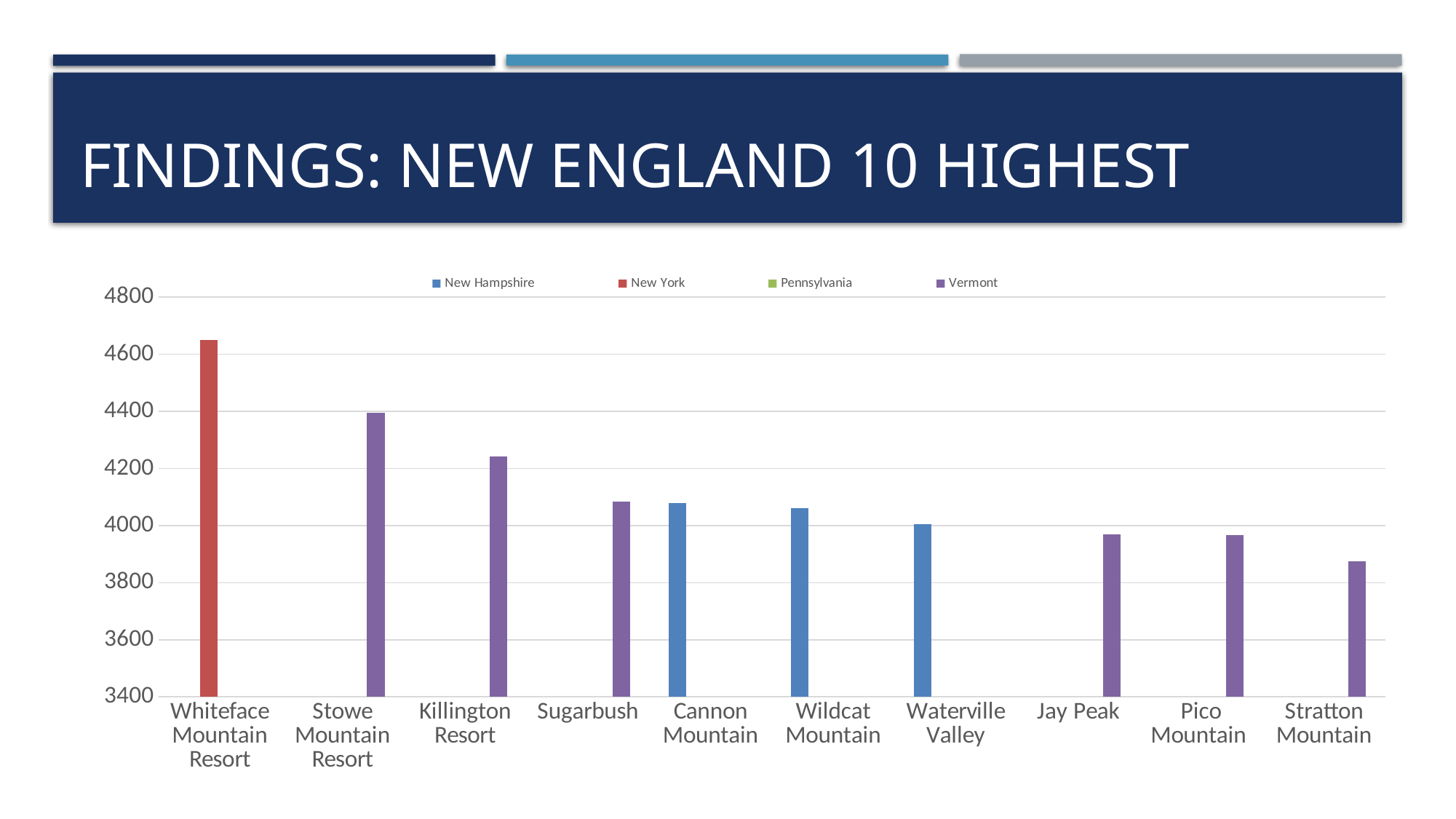
Is the value for Stratton Mountain greater or less than 4000? less Which resort has the highest bar? Whiteface Mountain Resort Do the bar values rise or fall from left to right across the chart? fall What kind of chart is shown on the slide? bar chart Is the value for Wildcat Mountain greater or less than 4000? greater Is the value for Killington Resort greater or less than 4200? greater How many series does the legend list? 4 How many resorts are plotted on the chart? 10 Which is larger, the value for Stowe Mountain Resort or Killington Resort? Stowe Mountain Resort Which resort has the lowest bar? Stratton Mountain Which legend series is shown in red? New York